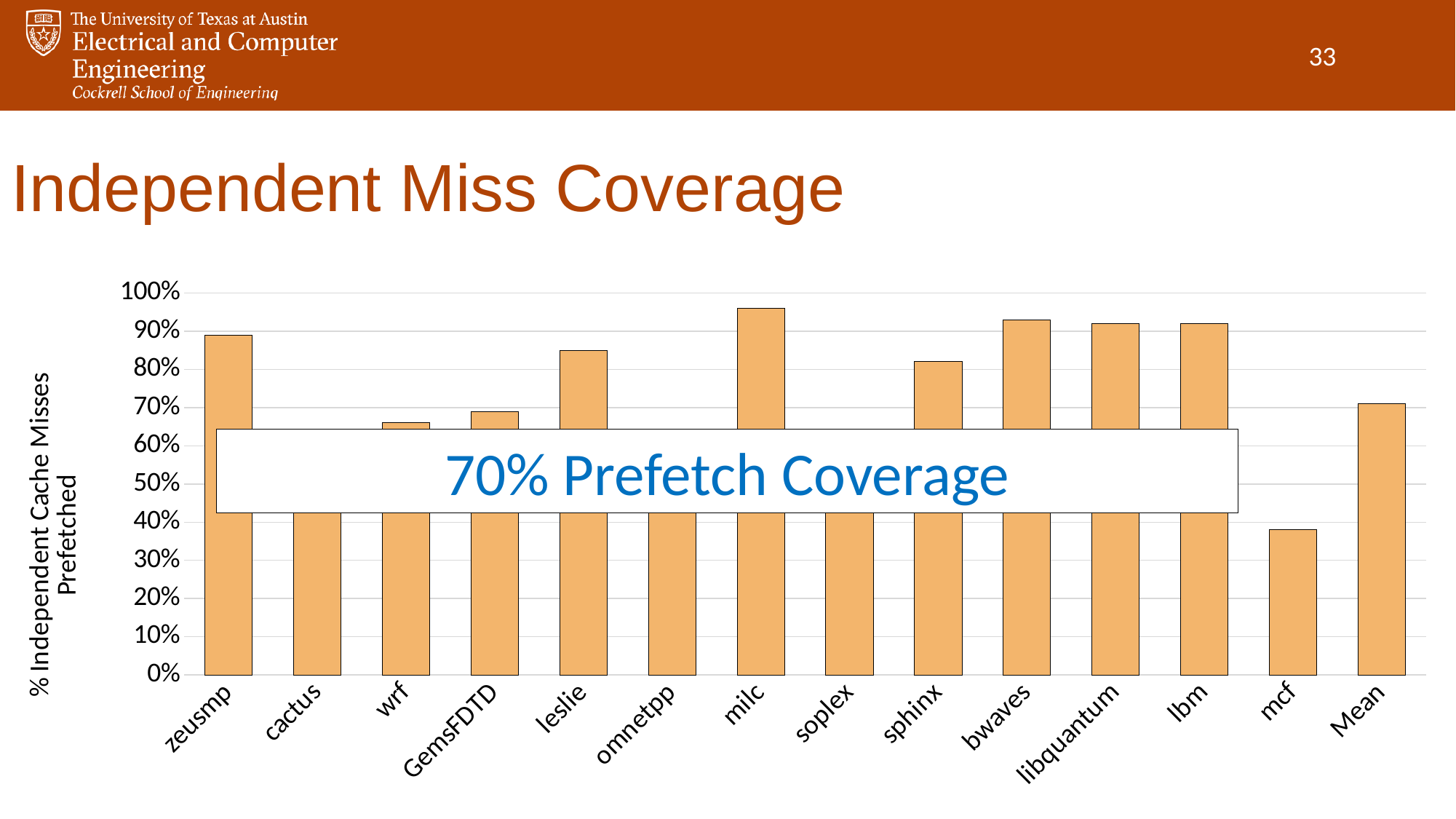
How many categories are shown on the x axis of the chart? 14 Is the value for mcf greater or less than 50%? less Which category has the highest value in the chart? milc Is the value for wrf greater or less than 70%? less Is the value for milc greater or less than 90%? greater Which has a larger value, leslie or wrf? leslie What kind of chart is shown on the slide? bar chart Which category has the lowest value in the chart? mcf What text is shown in the box overlaid on the chart? 70% Prefetch Coverage Which has a larger value, bwaves or sphinx? bwaves